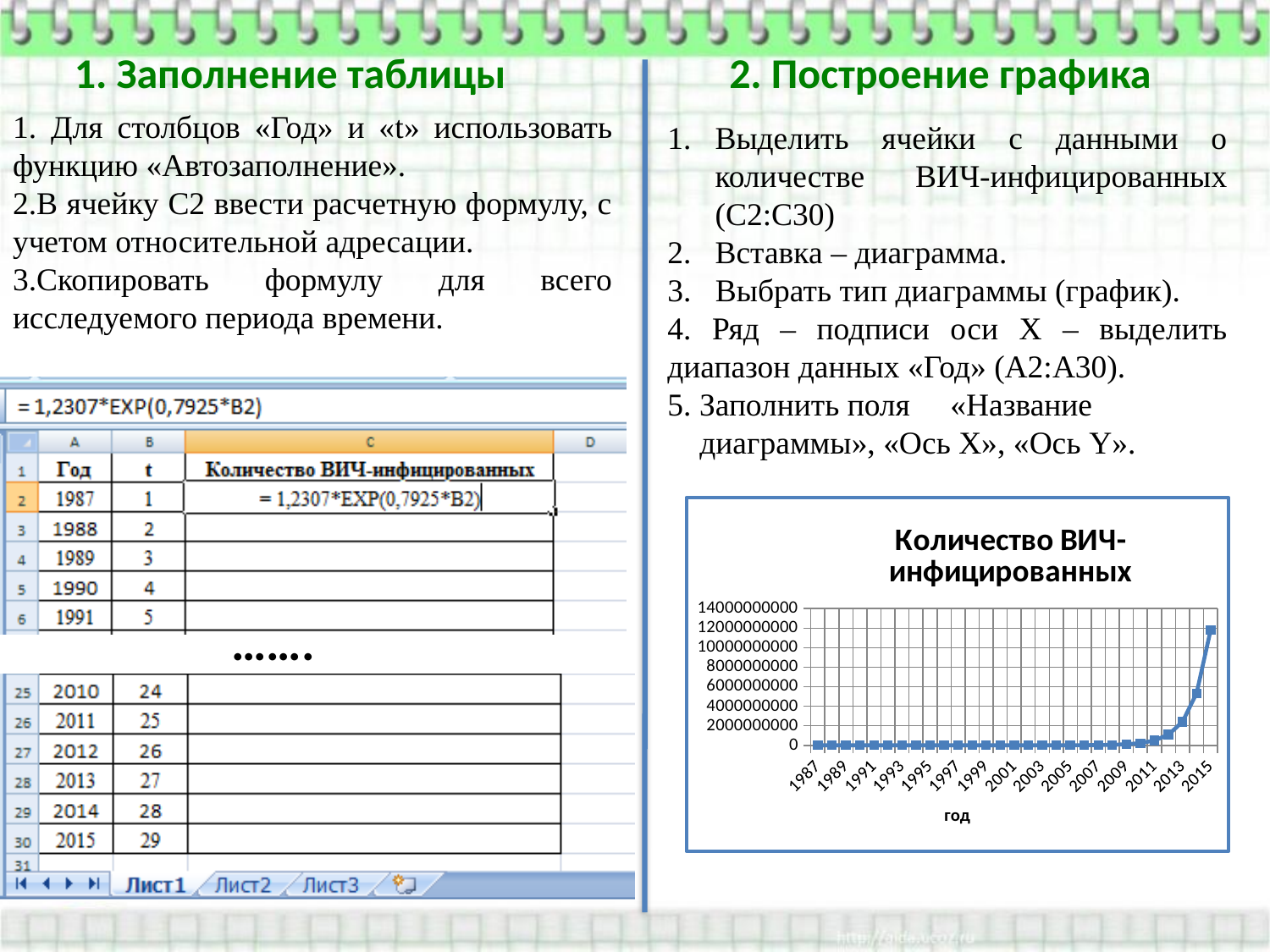
What is the highest tick value shown on the y-axis of the chart? 14000000000 What kind of chart is shown on the slide? line chart What is the title of the chart on the slide? Количество ВИЧ-инфицированных Do the values in the chart rise or fall as the years go from 1987 to 2015? rise Is the value for 2015 greater or less than 10000000000? greater Is the value for 2011 greater or less than 2000000000? less Is the value for 2014 greater or less than 8000000000? less Which year has the highest value in the chart? 2015 How many year labels are shown on the x-axis of the chart? 15 What is the x-axis title of the chart? год Which is larger, the value for 2015 or the value for 2014? 2015